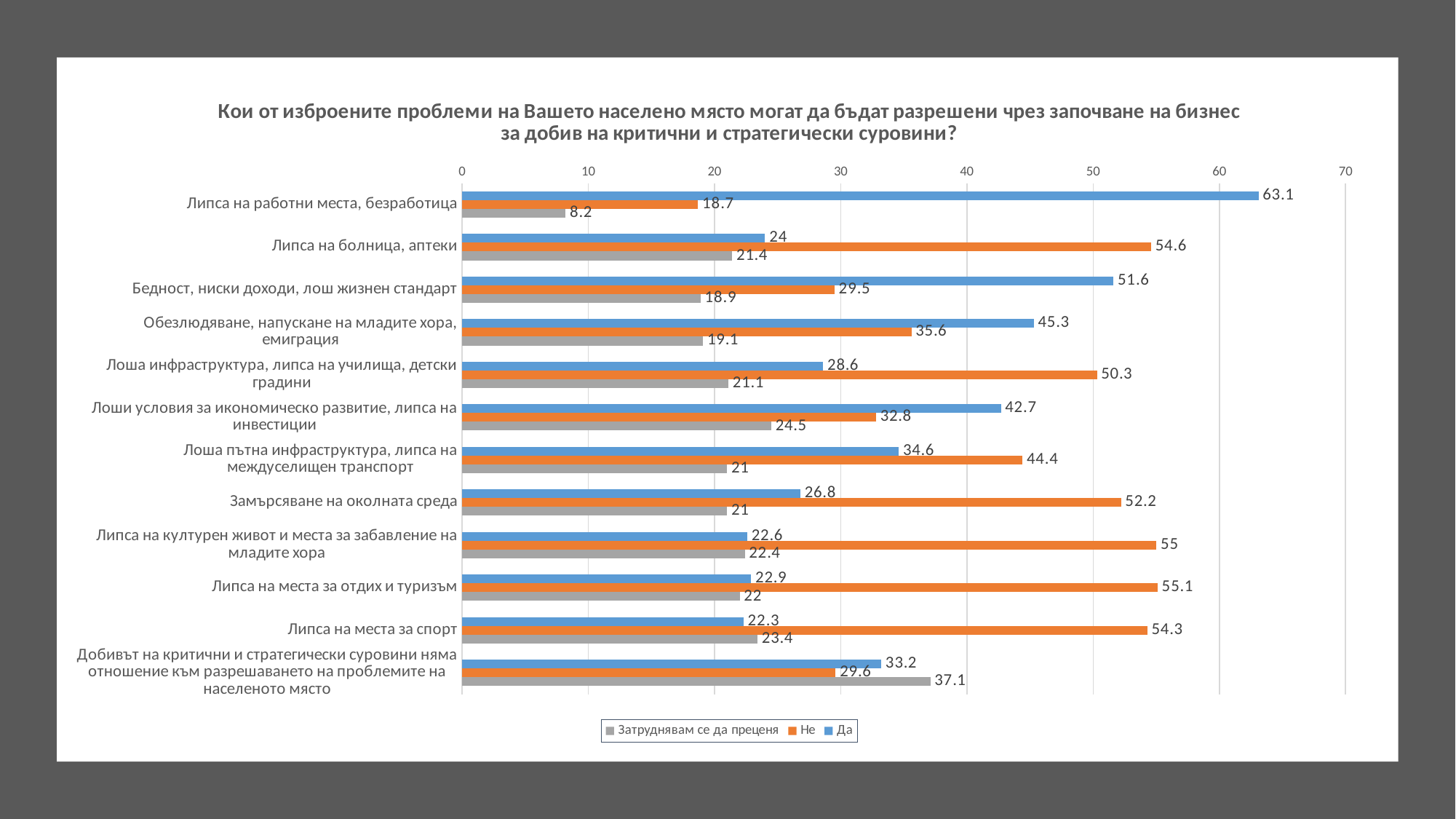
Which series is shown in orange in the legend? Не Which category has the lowest value in the "Не" series? Липса на работни места, безработица What is the difference between the "Не" and "Да" values for "Липса на болница, аптеки"? 30.6 What is the value of the "Затруднявам се да преценя" series for "Добивът на критични и стратегически суровини няма отношение към разрешаването на проблемите на населеното място"? 37.1 Which category has the highest value in the "Да" series? Липса на работни места, безработица How many categories (problems) are plotted on the chart? 12 What kind of chart is shown on the slide? bar chart How many series does the legend list? 3 What is the value of the "Не" series for "Замърсяване на околната среда"? 52.2 What is the value of the "Да" series for "Липса на работни места, безработица"? 63.1 For "Обезлюдяване, напускане на младите хора, емиграция", which is larger: the "Да" value or the "Не" value? Да Which category has the lowest value in the "Затруднявам се да преценя" series? Липса на работни места, безработица